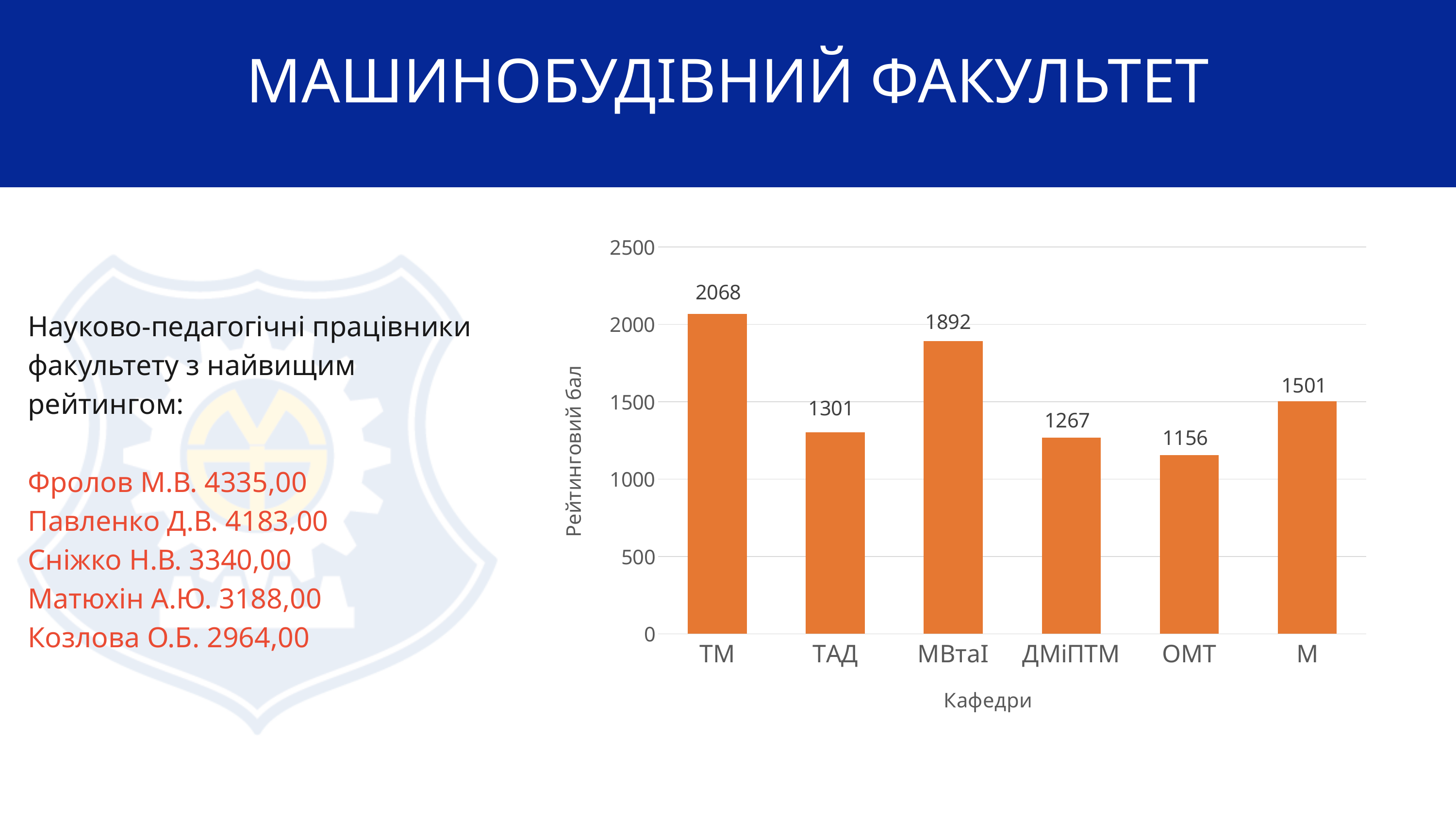
Which category has the highest value? ТМ What kind of chart is shown on the slide? bar chart What is the difference between the values for ТАД and ОМТ? 145 Which is larger, the value for ТАД or the value for М? М What is the label of the vertical axis? Рейтинговий бал Is the value for МВтаІ greater or less than 1500? greater What is the value for ДМіПТМ? 1267 What is the value for ТМ? 2068 Which category has the lowest value? ОМТ What is the difference between the values for ТМ and МВтаІ? 176 How many categories are shown on the x axis? 6 What is the value for М? 1501